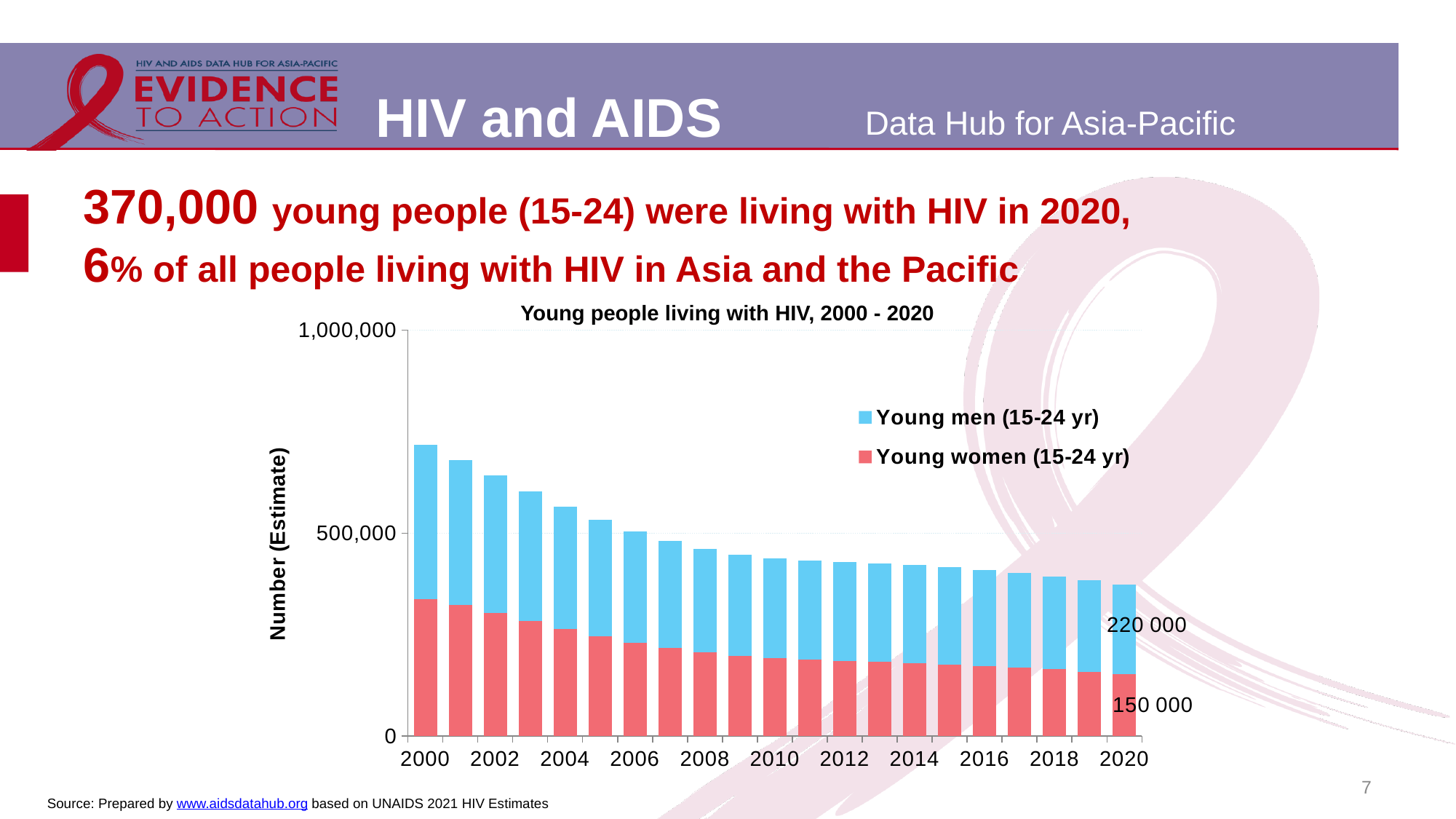
How many series does the legend list? 2 What is the total of the stacked bar for 2020? 370 000 In 2020, which is larger: the value for Young men (15-24 yr) or Young women (15-24 yr)? Young men (15-24 yr) Do the total values rise or fall from 2000 to 2020? Fall Is the total value for 2000 greater or less than 500,000? greater What is the value for Young men (15-24 yr) in 2020? 220 000 What is the difference between the Young men and Young women values in 2020? 70 000 What is the value for Young women (15-24 yr) in 2020? 150 000 What kind of chart is shown on the slide? Stacked bar chart What is the title of the chart? Young people living with HIV, 2000 - 2020 Which year has the highest total number of young people living with HIV? 2000 How many years (bars) are plotted on the x axis? 21